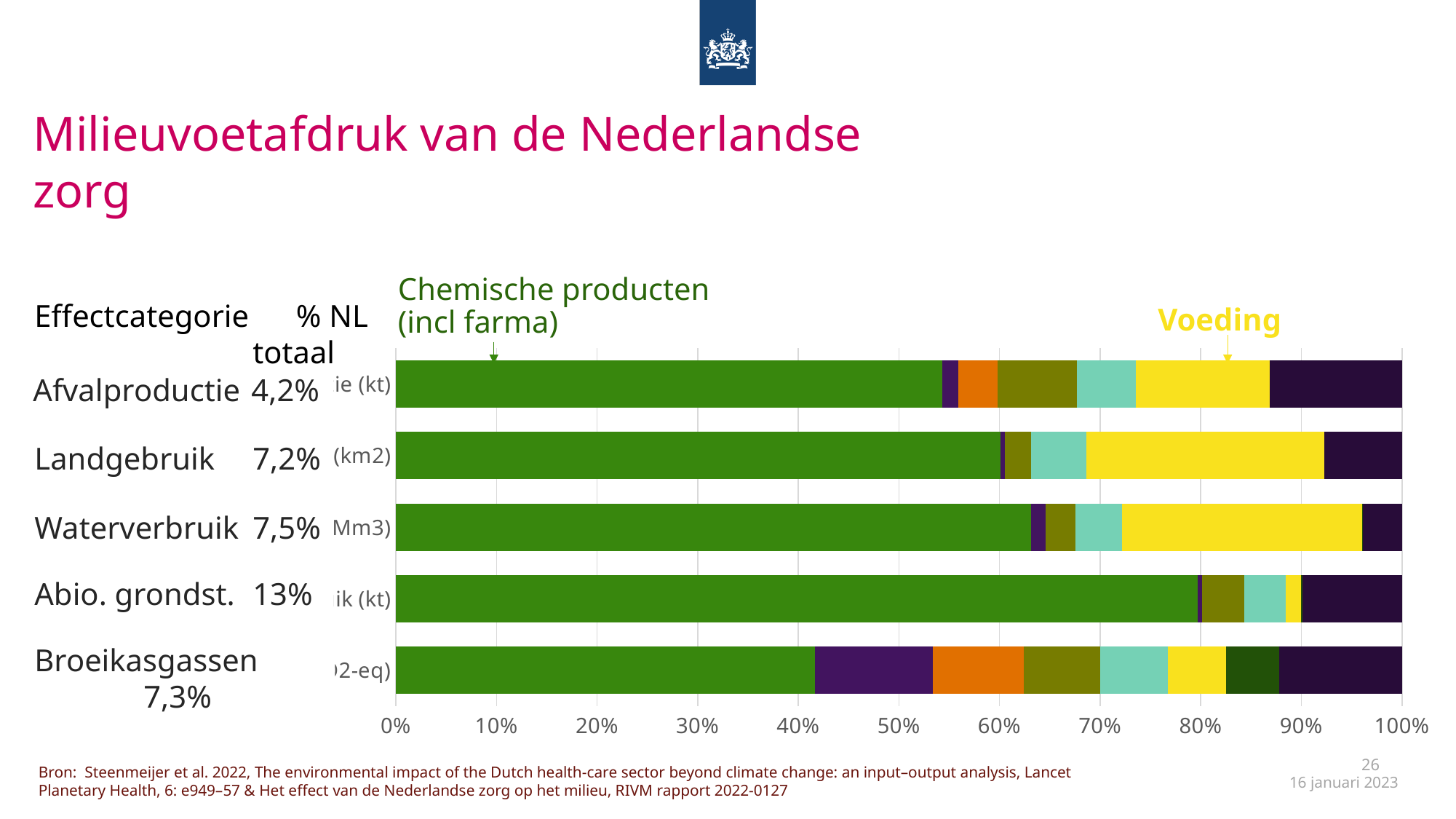
Is the Chemische producten (incl farma) share for Waterverbruik greater or less than 60%? greater Which effect category has the smallest share for Chemische producten (incl farma)? Broeikasgassen Is the Chemische producten (incl farma) share for Afvalproductie greater or less than 50%? greater Which effect category has the smallest share for Voeding? Abio. grondst. What kind of chart is shown on the slide? Stacked bar chart Which has a larger Voeding share: Afvalproductie or Abio. grondst.? Afvalproductie How many effect categories (bars) does the chart show? 5 What is the maximum value shown on the horizontal axis of the chart? 100% Which has a larger Chemische producten (incl farma) share: Afvalproductie or Broeikasgassen? Afvalproductie Is the Chemische producten (incl farma) share for Broeikasgassen greater or less than 50%? less What colour represents Voeding in the chart? Yellow Which effect category has the largest share for Chemische producten (incl farma)? Abio. grondst.